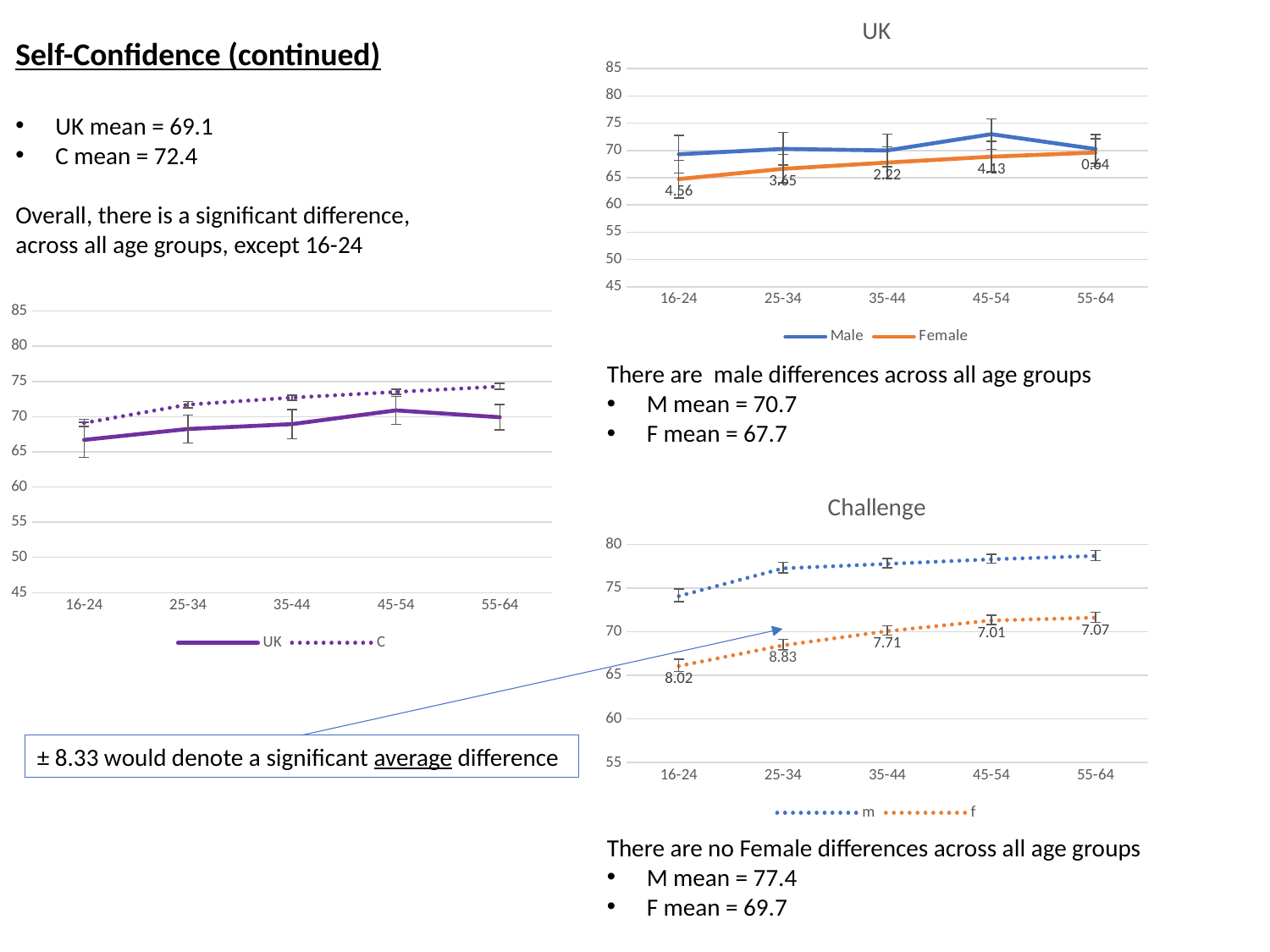
On the chart titled "UK", which age group has the highest Male value? 45-54 What kind of chart is the chart titled "UK"? line chart How many series does the legend of the chart titled "Challenge" list? 2 On the chart titled "UK", which age group has the lowest Female value? 16-24 How many age-group categories are shown on the x axis of the chart on the left of the slide? 5 On the chart titled "Challenge", do the f values generally rise or fall from 16-24 to 55-64? rise On the chart titled "UK", is the Female value for 16-24 greater or less than 70? less On the chart on the left of the slide, which series is plotted with a dotted line? C On the chart on the left of the slide, is the C value for 55-64 greater or less than 70? greater What are the two legend entries on the chart titled "UK"? Male and Female On the chart titled "Challenge", is the m value for 55-64 greater or less than 75? greater On the chart titled "Challenge", which is larger at 16-24, the m value or the f value? m